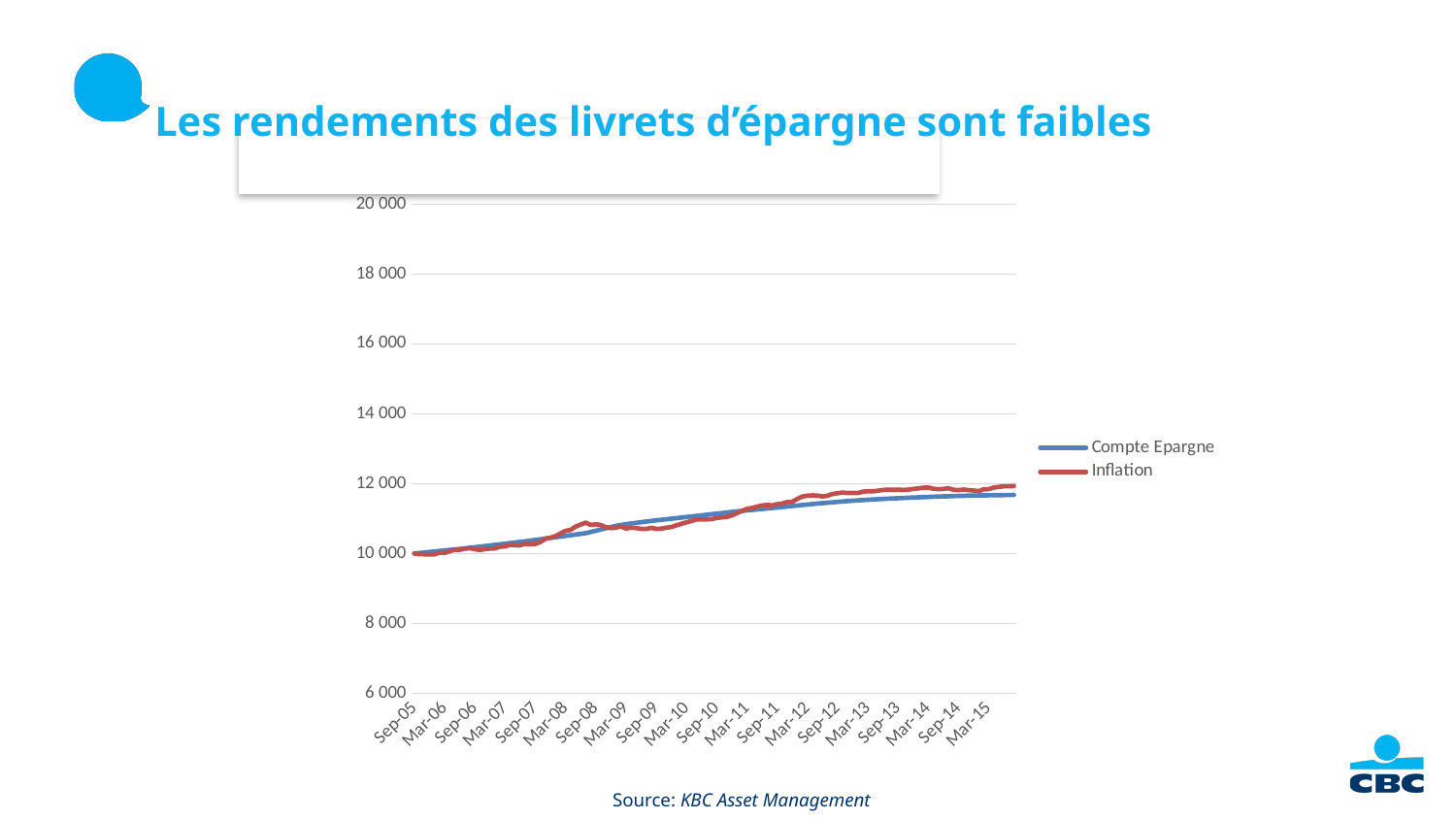
Is the value of Inflation at Mar-15 greater or less than 14 000? less Do the values of the Compte Epargne series rise or fall from Sep-05 to Mar-15? rise How many date labels are shown on the x axis? 20 Is the value of Compte Epargne at Mar-15 greater or less than 12 000? less At Mar-15, which series has the higher value, Compte Epargne or Inflation? Inflation How many series does the legend list? 2 Which series is drawn in red? Inflation What is the value of both series at Sep-05, the first point on the x axis? 10 000 At Sep-08, which series has the higher value, Compte Epargne or Inflation? Inflation What kind of chart is shown on the slide? line chart What are the two series named in the legend? Compte Epargne and Inflation Is the value of Inflation at Mar-10 greater or less than 10 000? greater